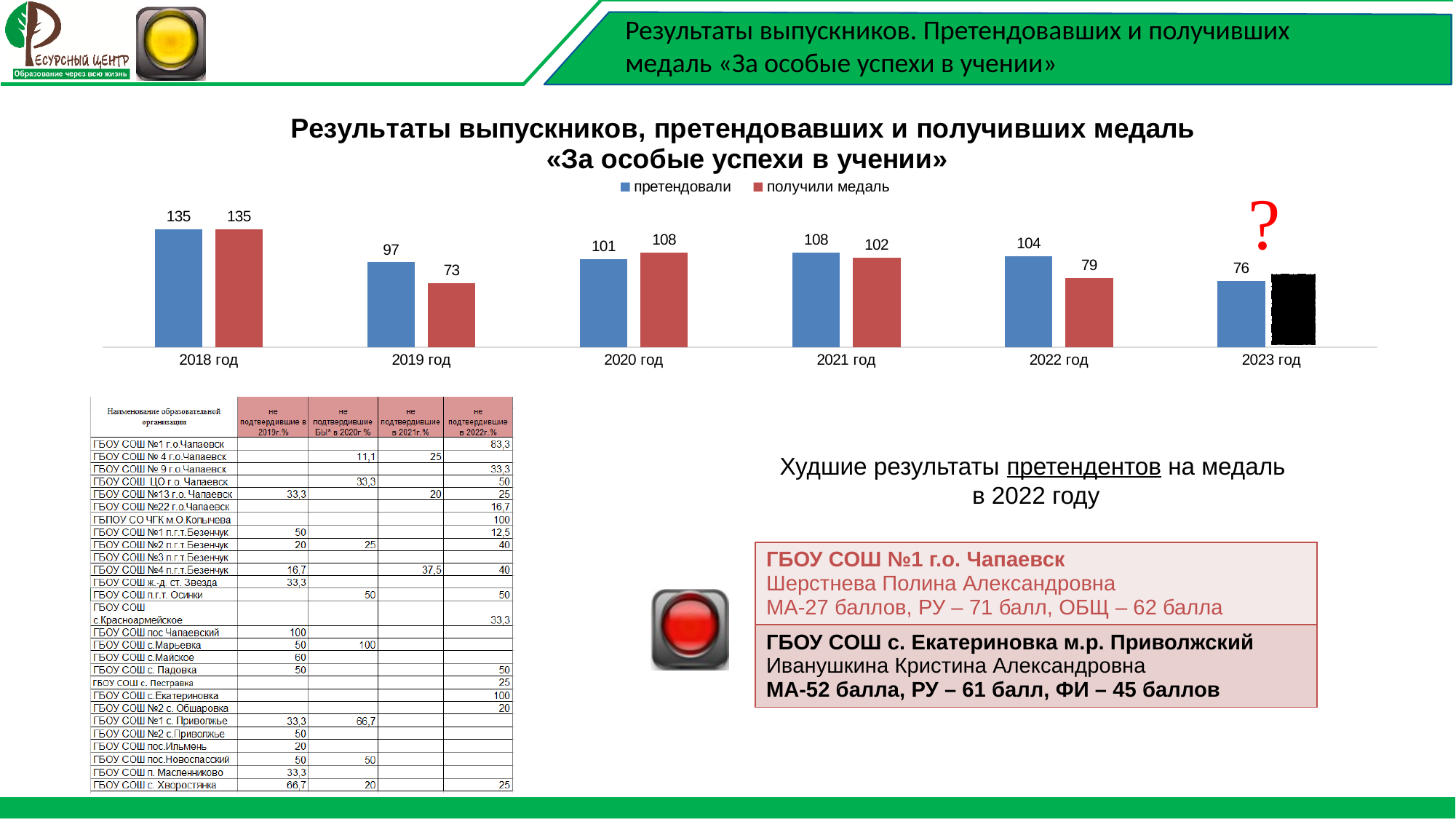
What type of chart is shown on the slide? bar chart How many year categories are shown on the x axis of the chart? 6 In which year is the value for "получили медаль" the lowest among the labelled values? 2019 год In which year is the value for "претендовали" the highest? 2018 год What is the value for "получили медаль" in 2022 год? 79 Which colour represents the "получили медаль" series in the chart? red How many series does the chart legend list? 2 What is the value for "претендовали" in 2023 год? 76 In 2020 год, which is larger: "претендовали" or "получили медаль"? получили медаль What is the value for "претендовали" in 2019 год? 97 What is the difference between "претендовали" and "получили медаль" in 2022 год? 25 What is the difference between "претендовали" and "получили медаль" in 2019 год? 24